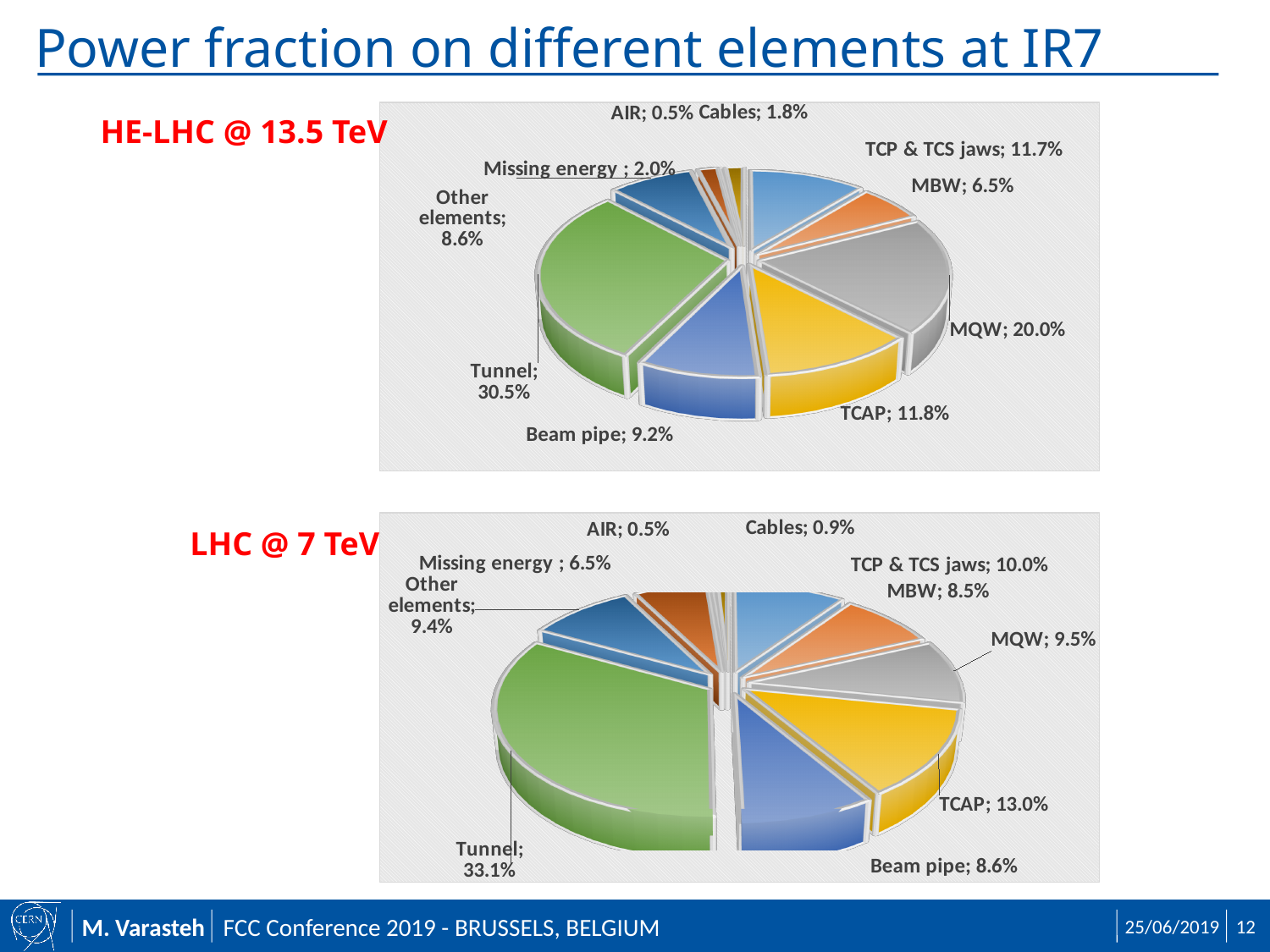
In the LHC @ 7 TeV chart, which element has the smallest power fraction? AIR In the HE-LHC @ 13.5 TeV chart, what is the power fraction for MQW? 20.0% In the HE-LHC @ 13.5 TeV chart, what is the power fraction for Tunnel? 30.5% In the LHC @ 7 TeV chart, what is the power fraction for TCAP? 13.0% In the LHC @ 7 TeV chart, what is the difference between the power fractions of Tunnel and TCAP? 20.1% In the HE-LHC @ 13.5 TeV chart, which is larger: the power fraction for TCAP or for Beam pipe? TCAP In the HE-LHC @ 13.5 TeV chart, what is the difference between the power fractions of MQW and MBW? 13.5% In the LHC @ 7 TeV chart, what is the power fraction for Missing energy? 6.5% In the HE-LHC @ 13.5 TeV chart, which element has the largest power fraction? Tunnel What type of chart is used for the HE-LHC @ 13.5 TeV data? Pie chart In the LHC @ 7 TeV chart, which is larger: the power fraction for MBW or for MQW? MQW How many slices does the LHC @ 7 TeV pie chart have? 10